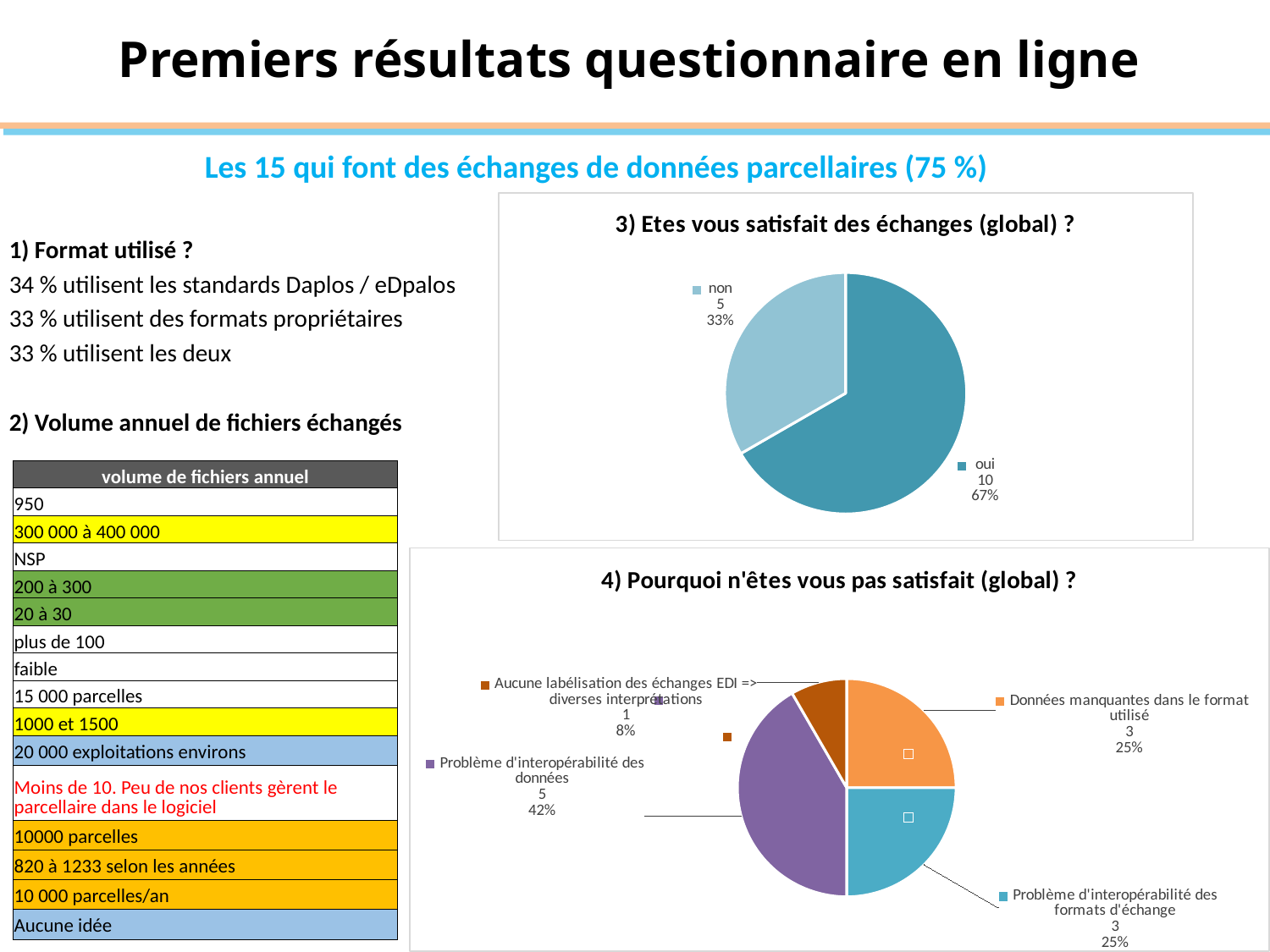
In the chart titled "3) Etes vous satisfait des échanges (global) ?", what kind of chart is shown? Pie chart In the chart titled "3) Etes vous satisfait des échanges (global) ?", what is the difference between the number of "oui" and "non" responses? 5 In the chart titled "4) Pourquoi n'êtes vous pas satisfait (global) ?", which is larger: "Problème d'interopérabilité des données" or "Problème d'interopérabilité des formats d'échange"? Problème d'interopérabilité des données In the chart titled "4) Pourquoi n'êtes vous pas satisfait (global) ?", which category has the smallest slice? Aucune labélisation des échanges EDI => diverses interprétations In the chart titled "3) Etes vous satisfait des échanges (global) ?", how many slices does the pie have? 2 In the chart titled "3) Etes vous satisfait des échanges (global) ?", how many respondents answered "oui"? 10 In the chart titled "3) Etes vous satisfait des échanges (global) ?", which category has the largest slice? oui In the chart titled "4) Pourquoi n'êtes vous pas satisfait (global) ?", how many responses are in "Données manquantes dans le format utilisé"? 3 In the chart titled "4) Pourquoi n'êtes vous pas satisfait (global) ?", what share of the pie is "Problème d'interopérabilité des données"? 42% In the chart titled "4) Pourquoi n'êtes vous pas satisfait (global) ?", which category has the largest slice? Problème d'interopérabilité des données In the chart titled "3) Etes vous satisfait des échanges (global) ?", what share of the pie is "non"? 33% In the chart titled "4) Pourquoi n'êtes vous pas satisfait (global) ?", how many categories does the pie have? 4